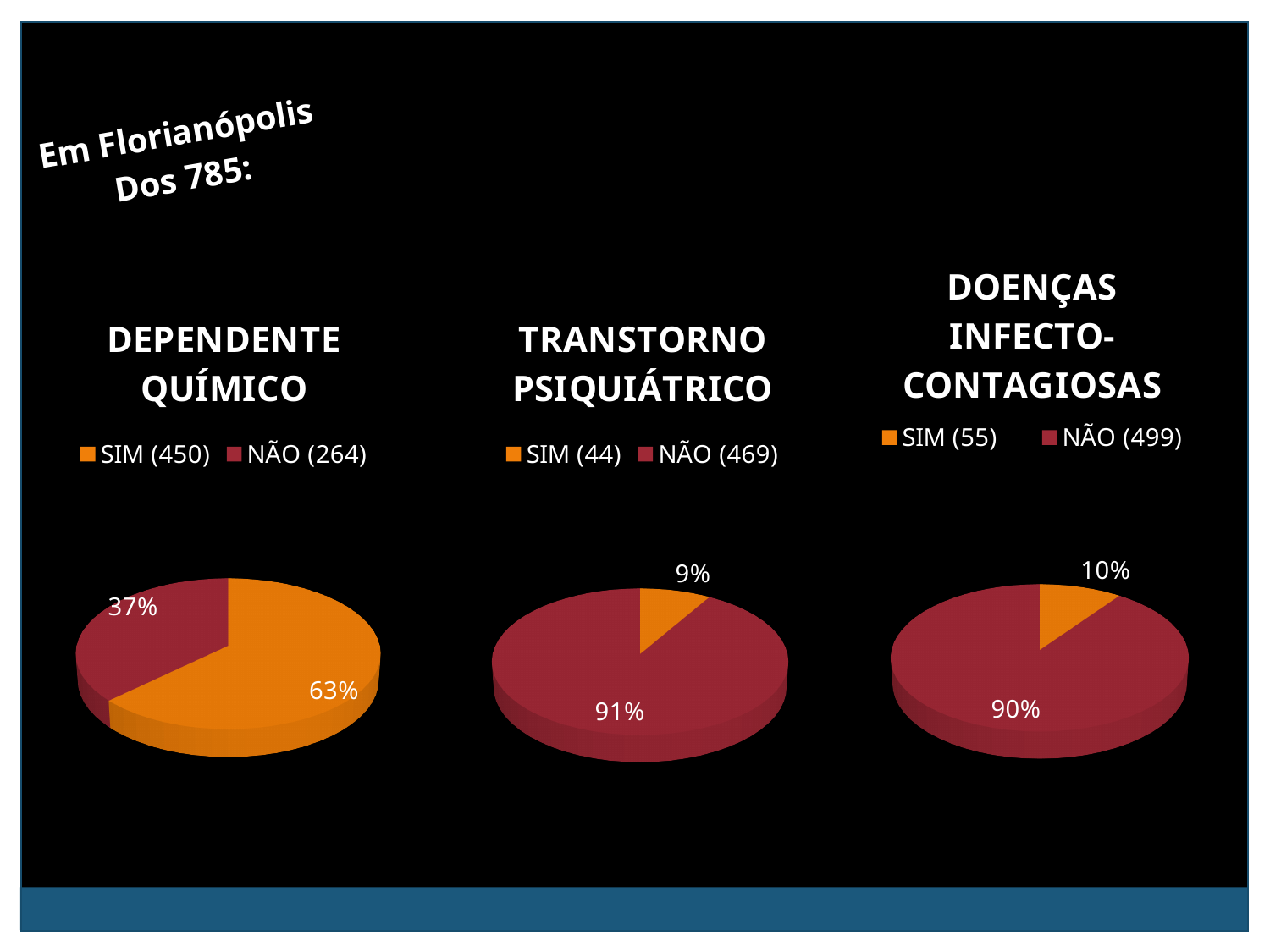
In the DEPENDENTE QUÍMICO chart, what share of the pie is NÃO? 37% In the TRANSTORNO PSIQUIÁTRICO chart, what share of the pie is SIM? 9% In the DEPENDENTE QUÍMICO chart, what share of the pie is SIM? 63% In the DOENÇAS INFECTO-CONTAGIOSAS chart, which slice is the largest? NÃO In the TRANSTORNO PSIQUIÁTRICO chart, which slice is the smallest? SIM How many slices does the TRANSTORNO PSIQUIÁTRICO pie chart have? 2 What kind of chart is the DEPENDENTE QUÍMICO chart? Pie chart In the DEPENDENTE QUÍMICO chart, which slice is larger, SIM or NÃO? SIM In the DEPENDENTE QUÍMICO chart, what count is shown in the legend for SIM? 450